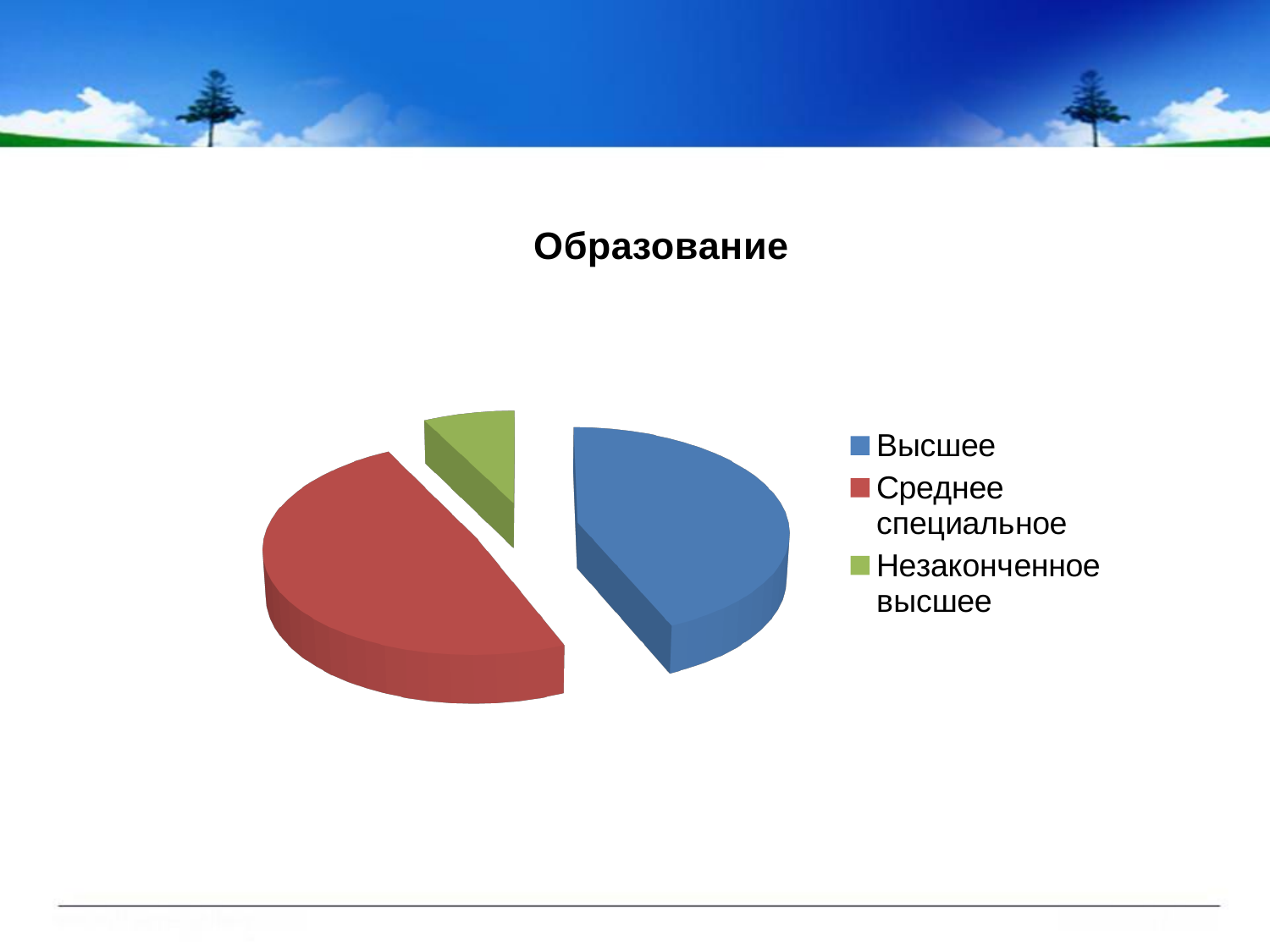
How many slices does the pie chart have? 3 What kind of chart is shown on the slide? pie chart What is the title of the chart? Образование Which category is shown in green? Незаконченное высшее Which slice is larger: Высшее or Незаконченное высшее? Высшее How many entries does the legend list? 3 What colour is the slice for Среднее специальное? red Which category has the smallest slice of the pie? Незаконченное высшее Which slice is larger: Среднее специальное or Незаконченное высшее? Среднее специальное